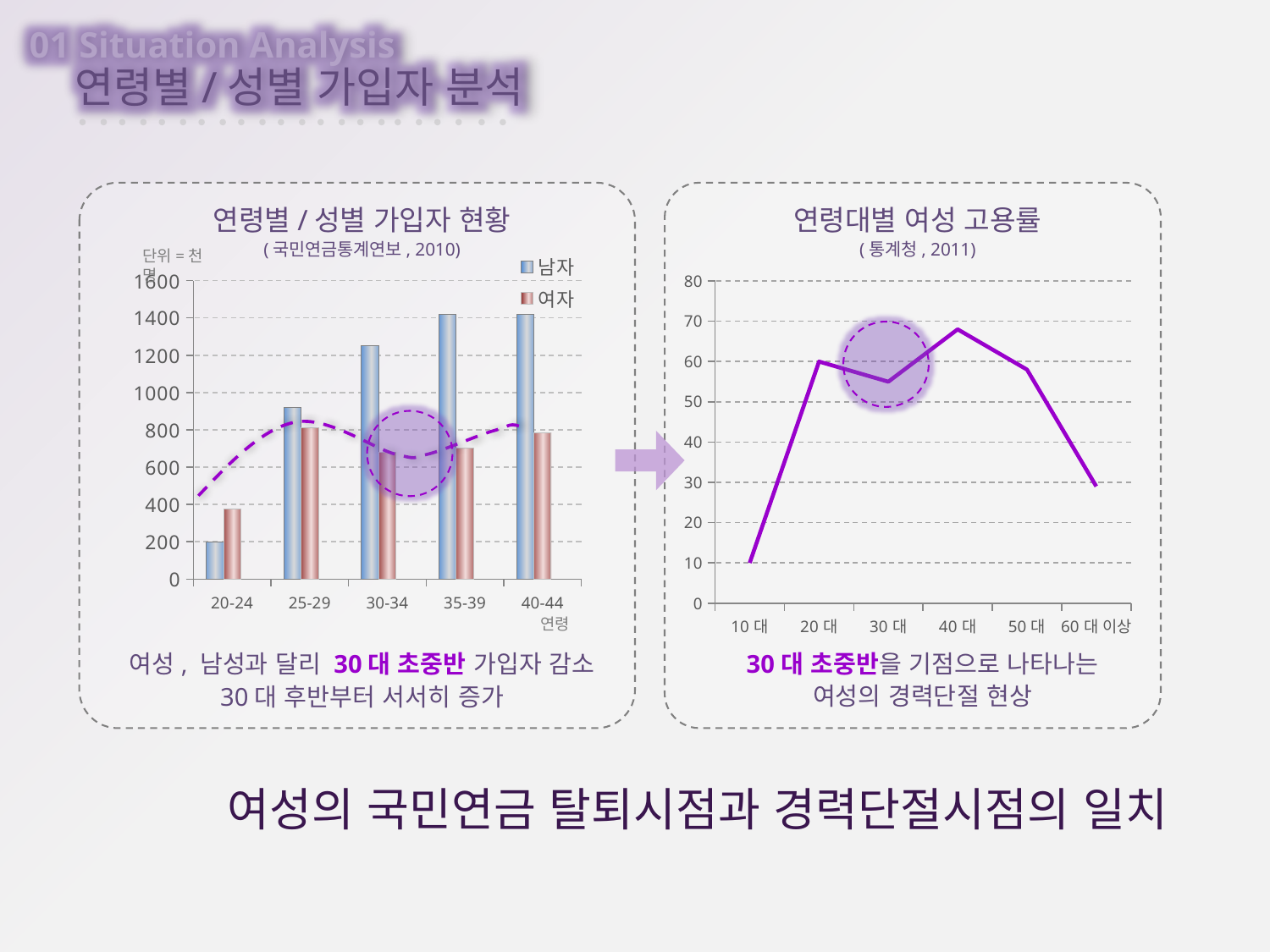
In the left chart (연령별 / 성별 가입자 현황), which age group has the lowest value for 남자? 20-24 In the right chart (연령대별 여성 고용률), how many age groups are plotted? 6 In the right chart (연령대별 여성 고용률), do the values rise or fall from 40 대 to 60 대 이상? fall What kind of chart is the left chart titled 연령별 / 성별 가입자 현황? bar chart In the left chart (연령별 / 성별 가입자 현황), is the value for 남자 in the 30-34 group greater or less than 1200? greater In the right chart (연령대별 여성 고용률), which age group has the highest value? 40 대 In the left chart (연령별 / 성별 가입자 현황), how many age categories are shown on the x axis? 5 What kind of chart is the right chart titled 연령대별 여성 고용률? line chart In the left chart (연령별 / 성별 가입자 현황), how many series does the legend list? 2 In the left chart (연령별 / 성별 가입자 현황), is the value for 여자 in the 30-34 group greater or less than 800? less In the left chart (연령별 / 성별 가입자 현황), which is larger in the 20-24 group, 남자 or 여자? 여자 In the right chart (연령대별 여성 고용률), is the value for 60 대 이상 greater or less than 40? less